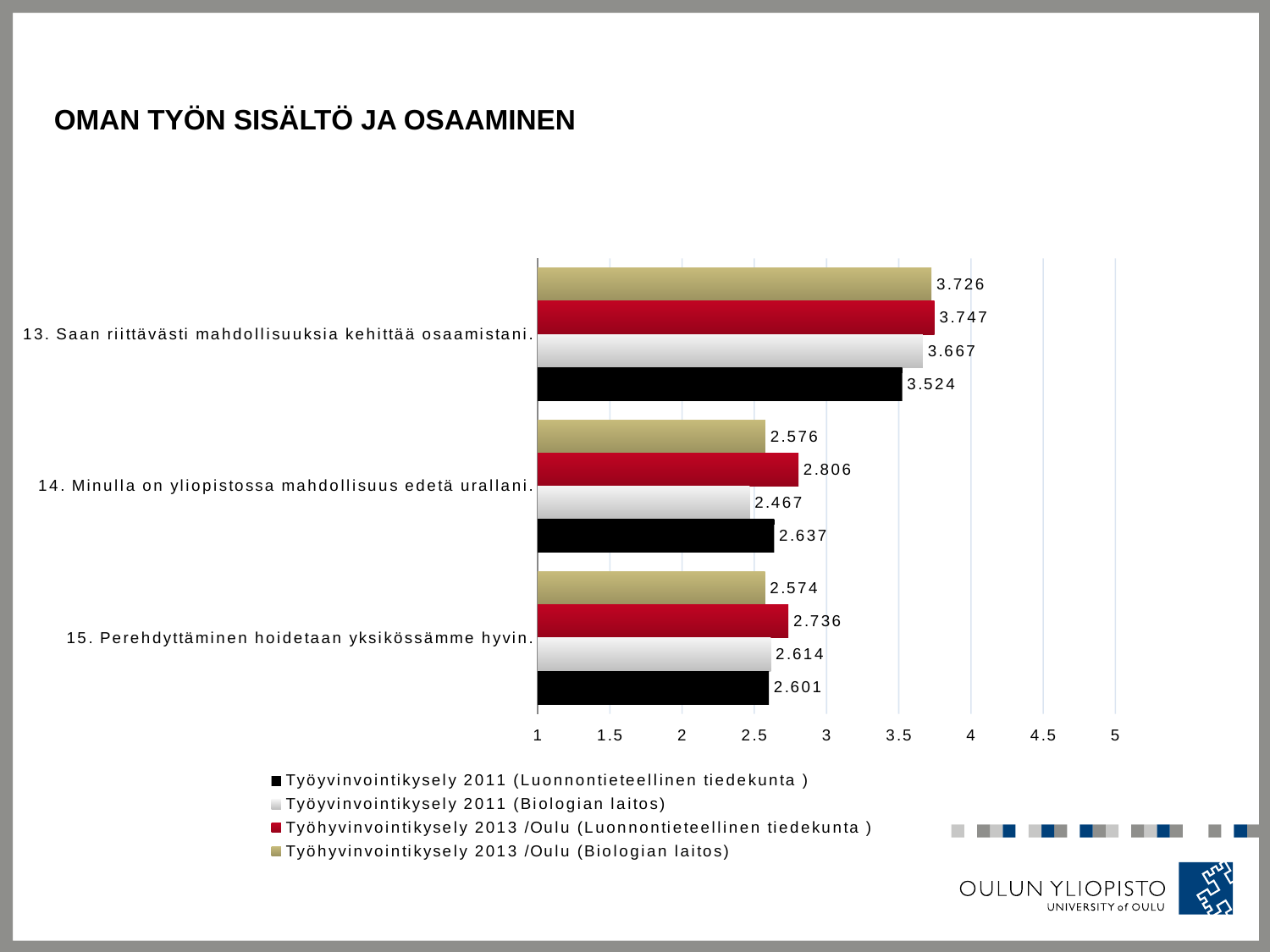
What is the value for Työhyvinvointikysely 2013 /Oulu (Biologian laitos) for statement 15 (Perehdyttäminen hoidetaan yksikössämme hyvin)? 2.574 What is the value for Työyvinvointikysely 2011 (Biologian laitos) for statement 14 (Minulla on yliopistossa mahdollisuus edetä urallani)? 2.467 What is the value for Työhyvinvointikysely 2013 /Oulu (Luonnontieteellinen tiedekunta) for statement 13 (Saan riittävästi mahdollisuuksia kehittää osaamistani)? 3.747 What type of chart is shown on the slide? Bar chart Is the value for Työyvinvointikysely 2011 (Biologian laitos) for statement 13 greater or less than 3.5? greater Which series has the highest value for statement 14 (Minulla on yliopistossa mahdollisuus edetä urallani)? Työhyvinvointikysely 2013 /Oulu (Luonnontieteellinen tiedekunta) Which series has the lowest value for statement 13 (Saan riittävästi mahdollisuuksia kehittää osaamistani)? Työyvinvointikysely 2011 (Luonnontieteellinen tiedekunta) How many series does the legend list? 4 For statement 14, which is larger: the Työyvinvointikysely 2011 (Luonnontieteellinen tiedekunta) value or the Työhyvinvointikysely 2013 /Oulu (Biologian laitos) value? Työyvinvointikysely 2011 (Luonnontieteellinen tiedekunta) What is the difference between the Työhyvinvointikysely 2013 /Oulu (Luonnontieteellinen tiedekunta) value and the Työyvinvointikysely 2011 (Luonnontieteellinen tiedekunta) value for statement 15? 0.135 What is the title of the slide? OMAN TYÖN SISÄLTÖ JA OSAAMINEN How many statement categories are plotted on the chart? 3